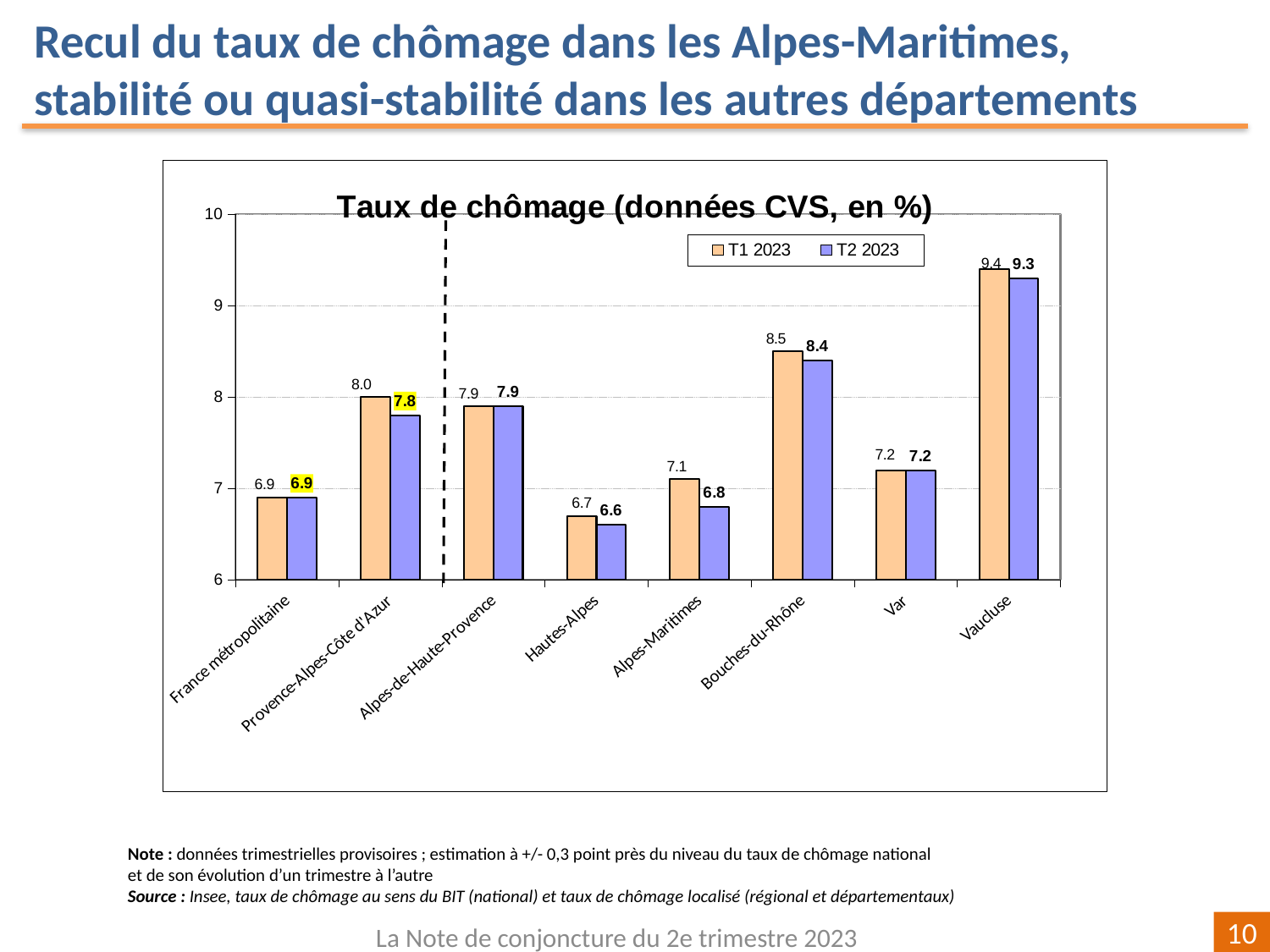
Which category has the highest T2 2023 value? Vaucluse Which category has the lowest T1 2023 value? Hautes-Alpes What is the T2 2023 value for Hautes-Alpes? 6.6 What is the T2 2023 value for Alpes-Maritimes? 6.8 How many series does the legend list? 2 Which is larger, the T1 2023 value for Bouches-du-Rhône or the T1 2023 value for Var? Bouches-du-Rhône How many categories are shown on the x axis? 8 What type of chart is shown on the slide? Bar chart Is the T2 2023 value for Vaucluse greater or less than 9? greater What is the difference between the T1 2023 and T2 2023 values for Alpes-Maritimes? 0.3 What is the T1 2023 value for Provence-Alpes-Côte d'Azur? 8.0 What is the title of the chart? Taux de chômage (données CVS, en %)